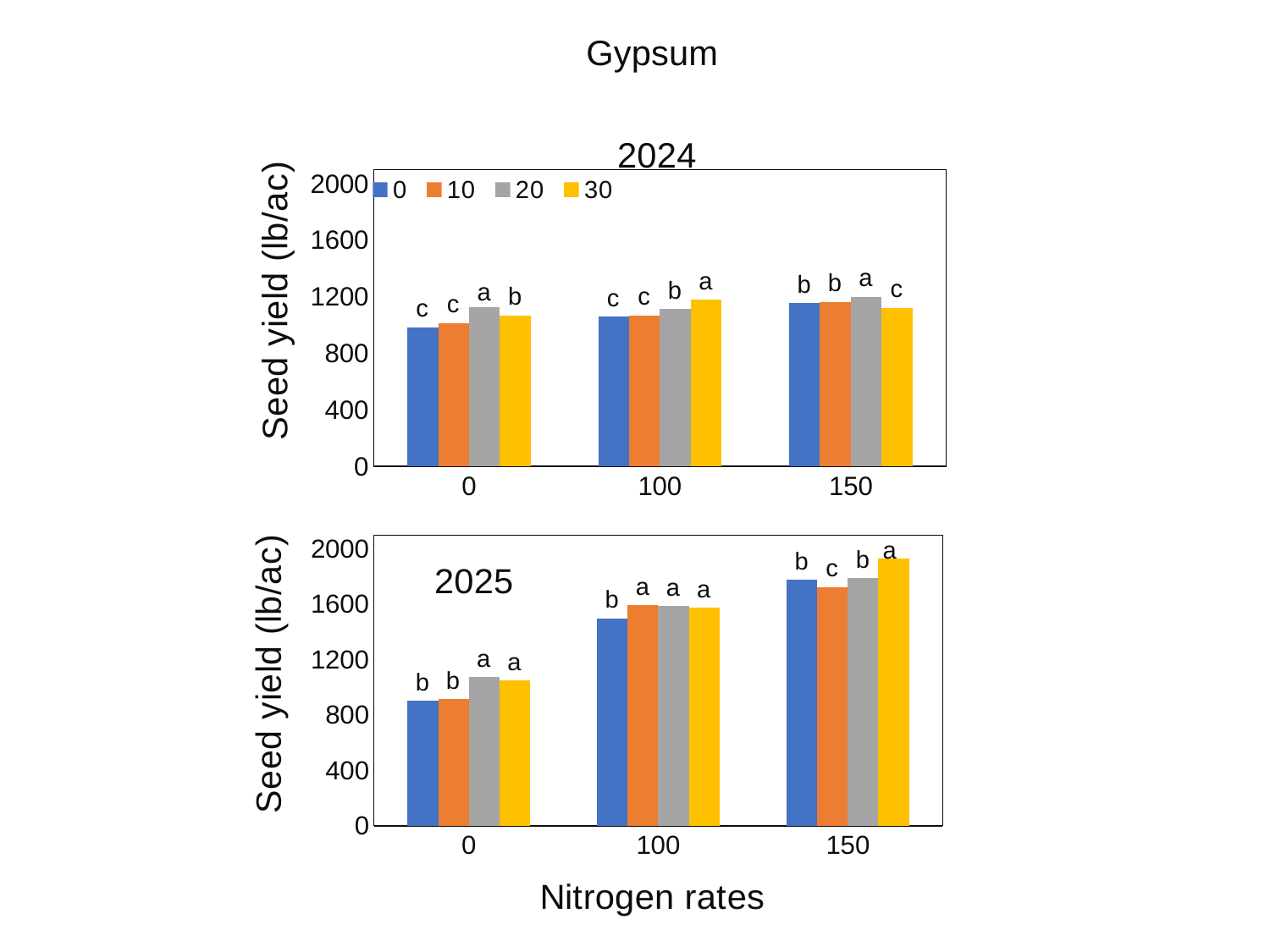
How many nitrogen rate categories are shown on the x axis of the 2025 chart? 3 How many series does the legend of the 2024 chart list? 4 In the 2024 chart, is the value for series 30 at nitrogen rate 100 greater or less than 800? greater In the 2025 chart, which series has the highest value at nitrogen rate 150? 30 In the 2024 chart, which series has the highest value at nitrogen rate 100? 30 In the 2025 chart, is the value for series 30 at nitrogen rate 150 greater or less than 1600? greater In the 2025 chart, at nitrogen rate 100, which is larger: series 0 or series 10? 10 What kind of chart is the 2024 chart? bar chart In the 2025 chart, does the value for series 0 rise or fall as the nitrogen rate increases from 0 to 150? rise In the 2025 chart, at nitrogen rate 0, which is larger: series 0 or series 20? 20 What is the y-axis label of the 2025 chart? Seed yield (lb/ac) In the 2025 chart, is the value for series 0 at nitrogen rate 0 greater or less than 1200? less